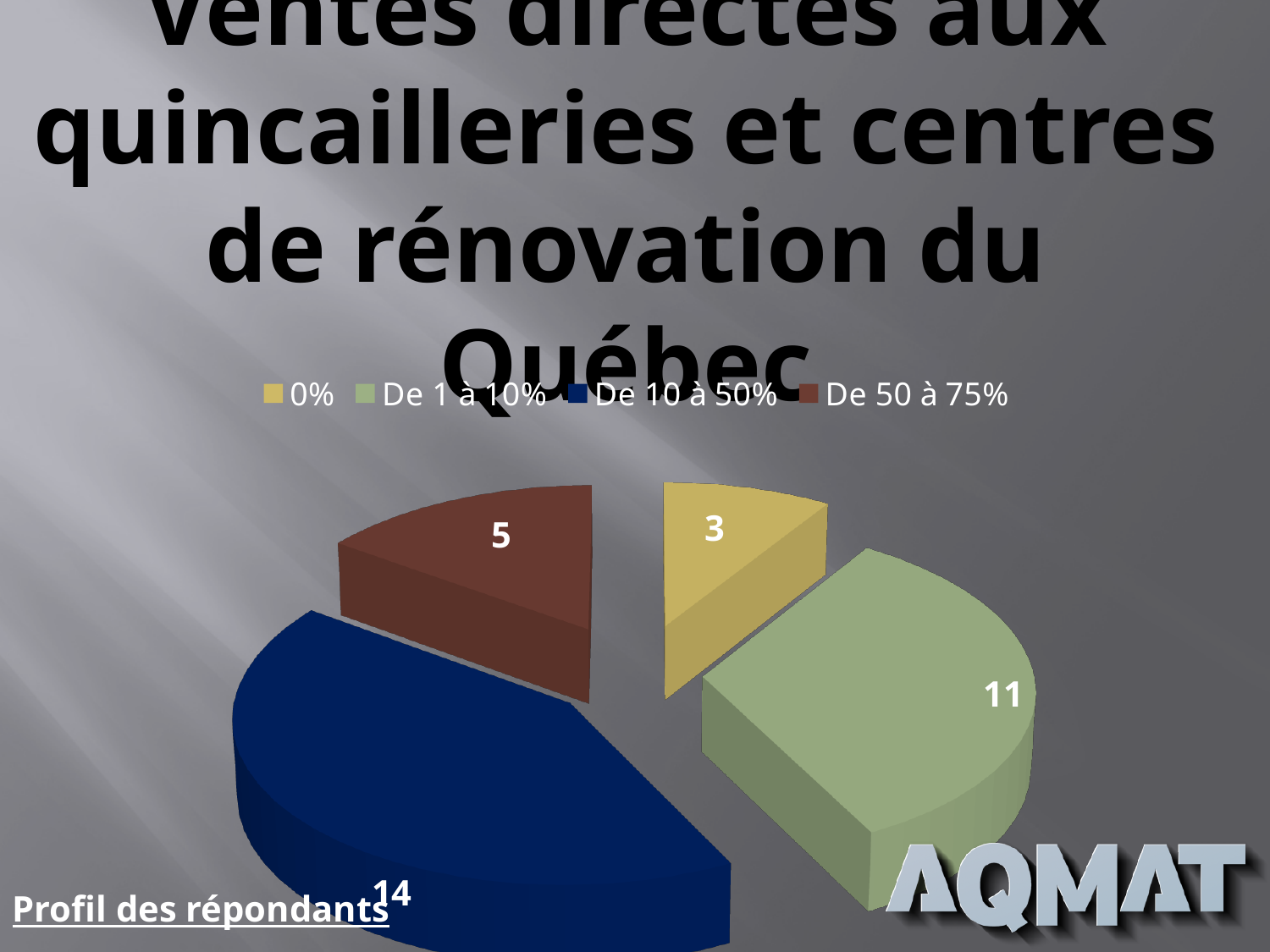
Which category has the largest slice of the pie? De 10 à 50% What is the value of the '0%' slice? 3 What is the value of the 'De 10 à 50%' slice? 14 How many categories does the legend of the pie chart list? 4 What is the value of the 'De 50 à 75%' slice? 5 What colour is the 'De 10 à 50%' slice in the pie chart? blue What is the value of the 'De 1 à 10%' slice? 11 What is the total of all the slice values in the pie chart? 33 What kind of chart is shown on the slide? pie chart Which is larger, the 'De 50 à 75%' slice or the '0%' slice? De 50 à 75% Which category has the smallest slice of the pie? 0% What is the difference between the 'De 10 à 50%' slice and the 'De 1 à 10%' slice? 3